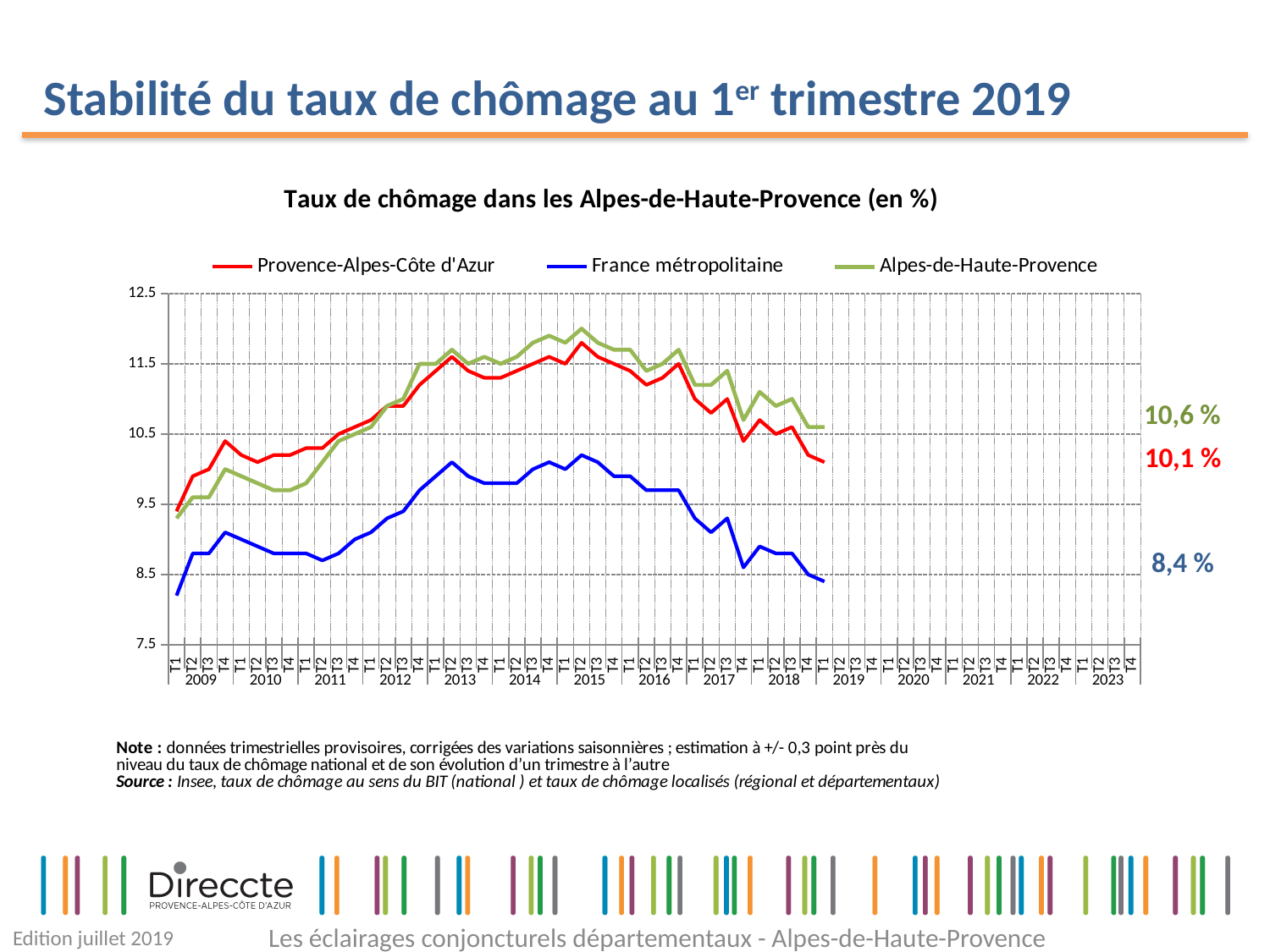
What is the difference between the latest values for Alpes-de-Haute-Provence and France métropolitaine? 2,2 points How many series does the legend list? 3 Is the value for Alpes-de-Haute-Provence at T2 2015 greater or less than 11.5? greater What is the latest unemployment rate shown for Provence-Alpes-Côte d'Azur? 10,1 % What is the latest unemployment rate shown for France métropolitaine? 8,4 % Does the France métropolitaine line rise or fall between T4 2016 and T1 2019? fall What kind of chart is shown on the slide? line chart Which series has the lowest value at the end of the chart (T1 2019)? France métropolitaine What is the difference between the latest values for Provence-Alpes-Côte d'Azur and France métropolitaine? 1,7 points Is the value for France métropolitaine at T1 2009 greater or less than 8.5? less Which series has the highest value at the end of the chart (T1 2019)? Alpes-de-Haute-Provence What is the latest unemployment rate shown for Alpes-de-Haute-Provence? 10,6 %